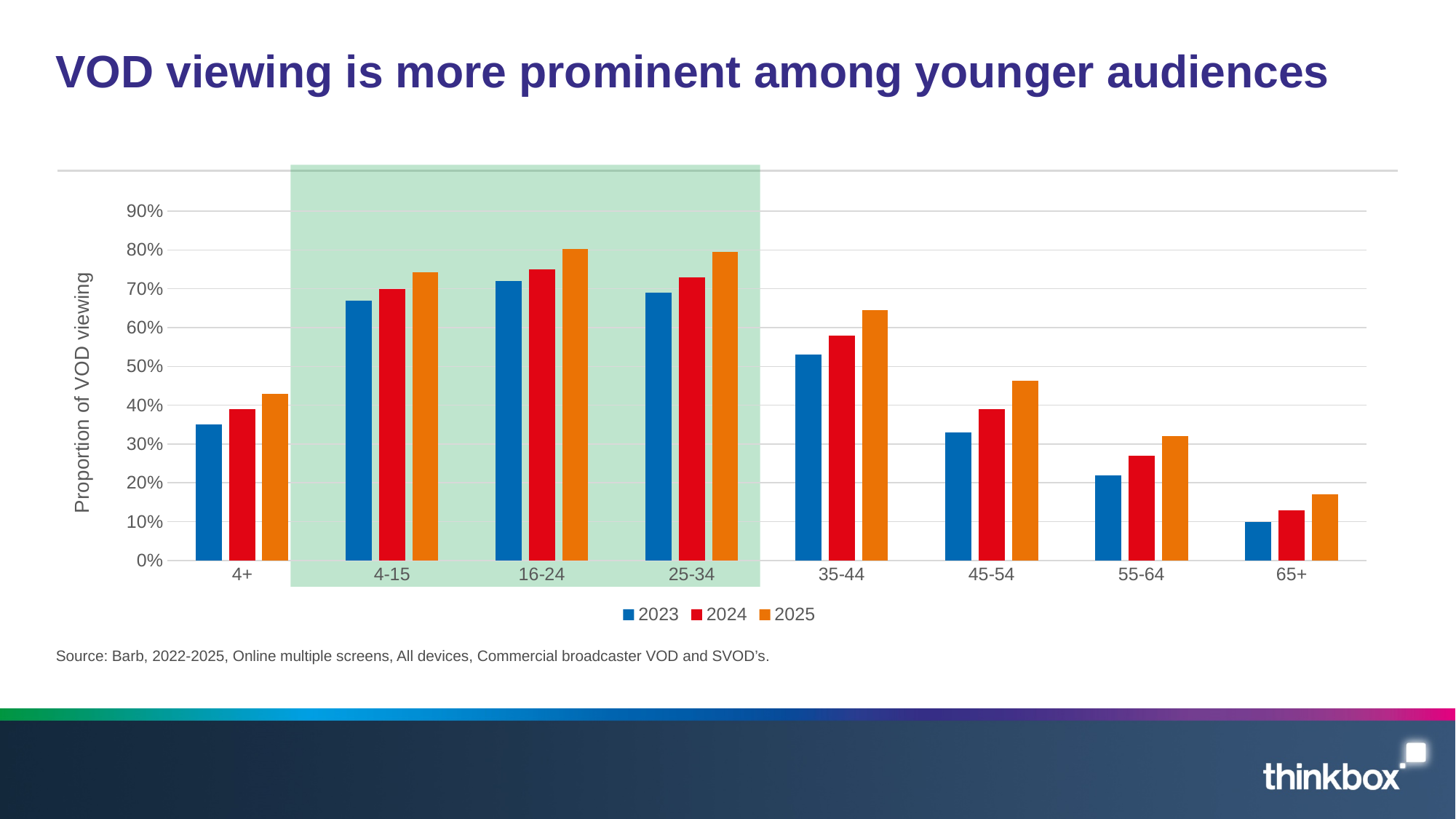
Which colour represents the 2025 series in the legend? orange Which age group has the lowest value for 2023? 65+ Which age group has the lowest value for 2025? 65+ Is the 2023 value for 4+ greater or less than 30%? greater How many age groups are shown on the x axis? 8 Is the 2025 value for 35-44 greater or less than 60%? greater How many series does the legend list? 3 Is the 2024 value for 35-44 greater or less than 60%? less Within each age group, do the values rise or fall from 2023 to 2025? rise Which is larger, the 2025 value for 35-44 or the 2025 value for 45-54? 35-44 What kind of chart is shown on the slide? bar chart